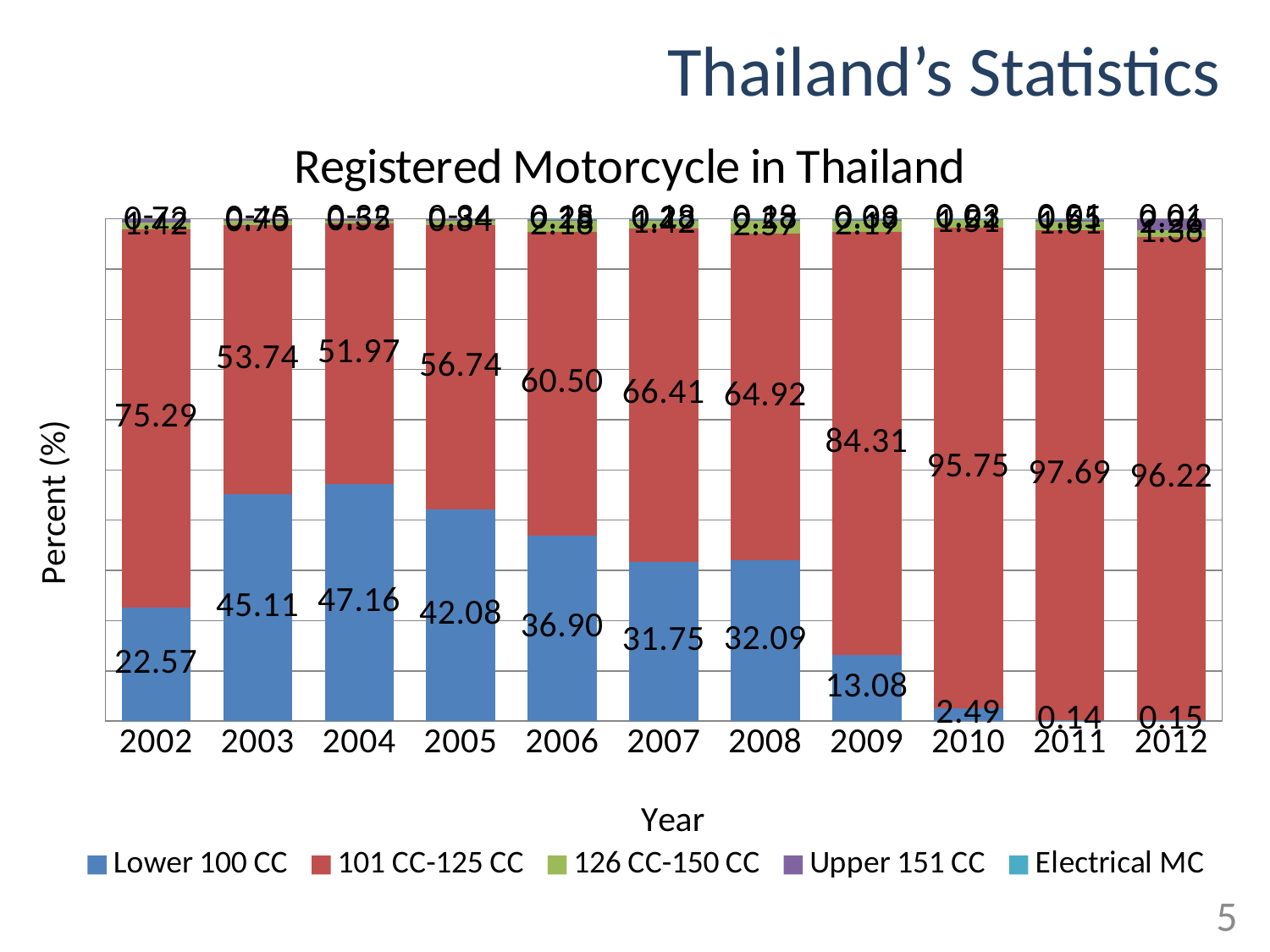
In which year is the Lower 100 CC value highest? 2004 In which year is the 101 CC-125 CC value highest? 2011 Which year has the larger Lower 100 CC value, 2007 or 2008? 2008 What is the value for Lower 100 CC in 2002? 22.57 What is the value for Lower 100 CC in 2009? 13.08 How many years are shown on the x axis? 11 What is the difference between the 101 CC-125 CC value and the Lower 100 CC value in 2002? 52.72 What kind of chart is this? Stacked bar chart What is the value for 101 CC-125 CC in 2010? 95.75 Does the Lower 100 CC value rise or fall from 2004 to 2012? Fall How many series does the legend list? 5 In which year is the 101 CC-125 CC value lowest? 2004